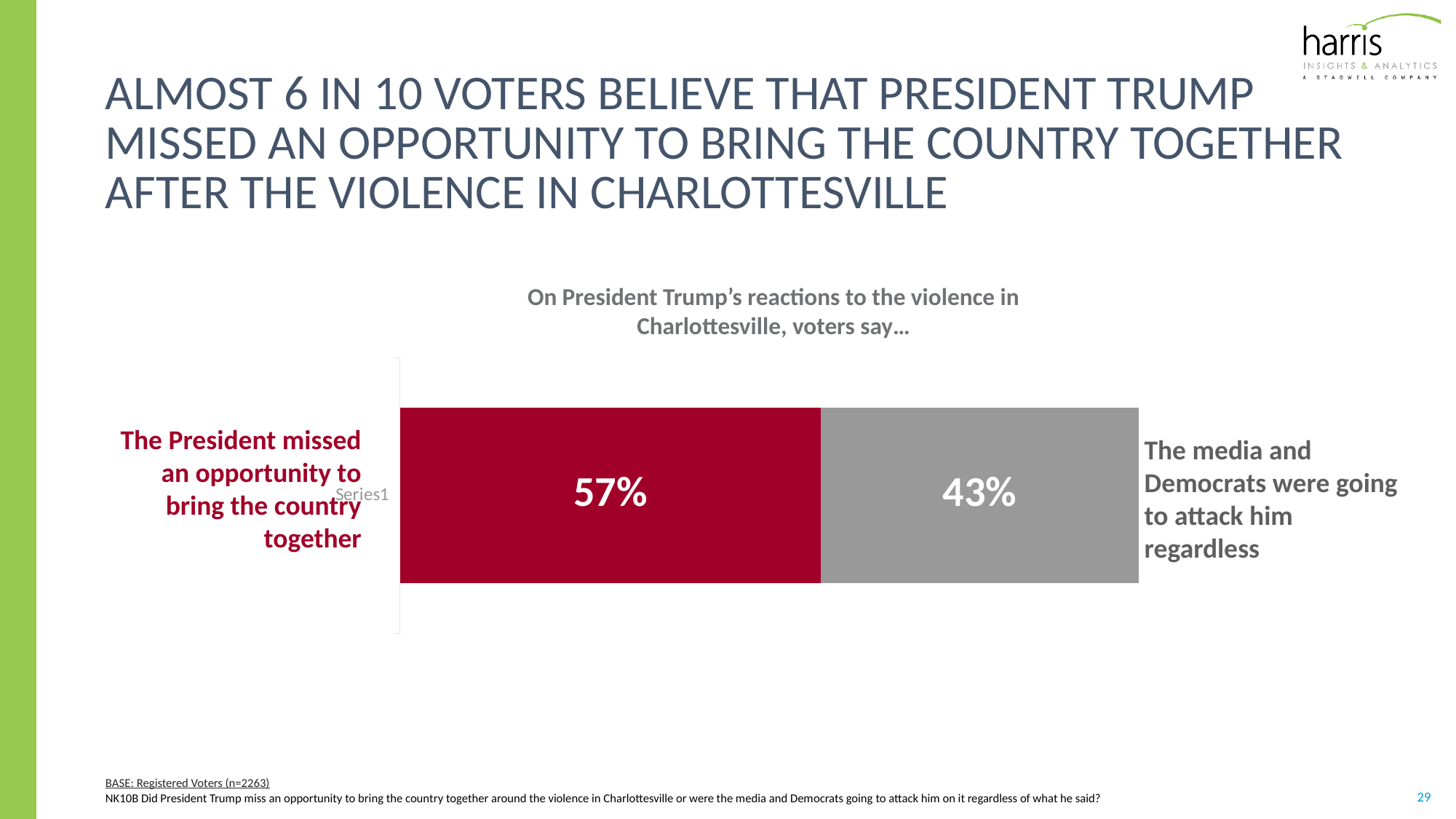
Which response has the largest share in the chart? The President missed an opportunity to bring the country together Which response has the smallest share in the chart? The media and Democrats were going to attack him regardless What is the total of the two segments in the stacked bar? 100% What kind of chart is shown on the slide? Stacked bar chart What is the difference in percentage points between the two responses shown in the bar? 14 percentage points Which response has the larger share: 'The President missed an opportunity to bring the country together' or 'The media and Democrats were going to attack him regardless'? The President missed an opportunity to bring the country together What is the title of the chart? On President Trump's reactions to the violence in Charlottesville, voters say… What percentage of voters say the President missed an opportunity to bring the country together? 57% How many segments make up the bar in the chart? 2 Which colour is used for the segment representing 'The President missed an opportunity to bring the country together'? Red What percentage of voters say the media and Democrats were going to attack him regardless? 43%